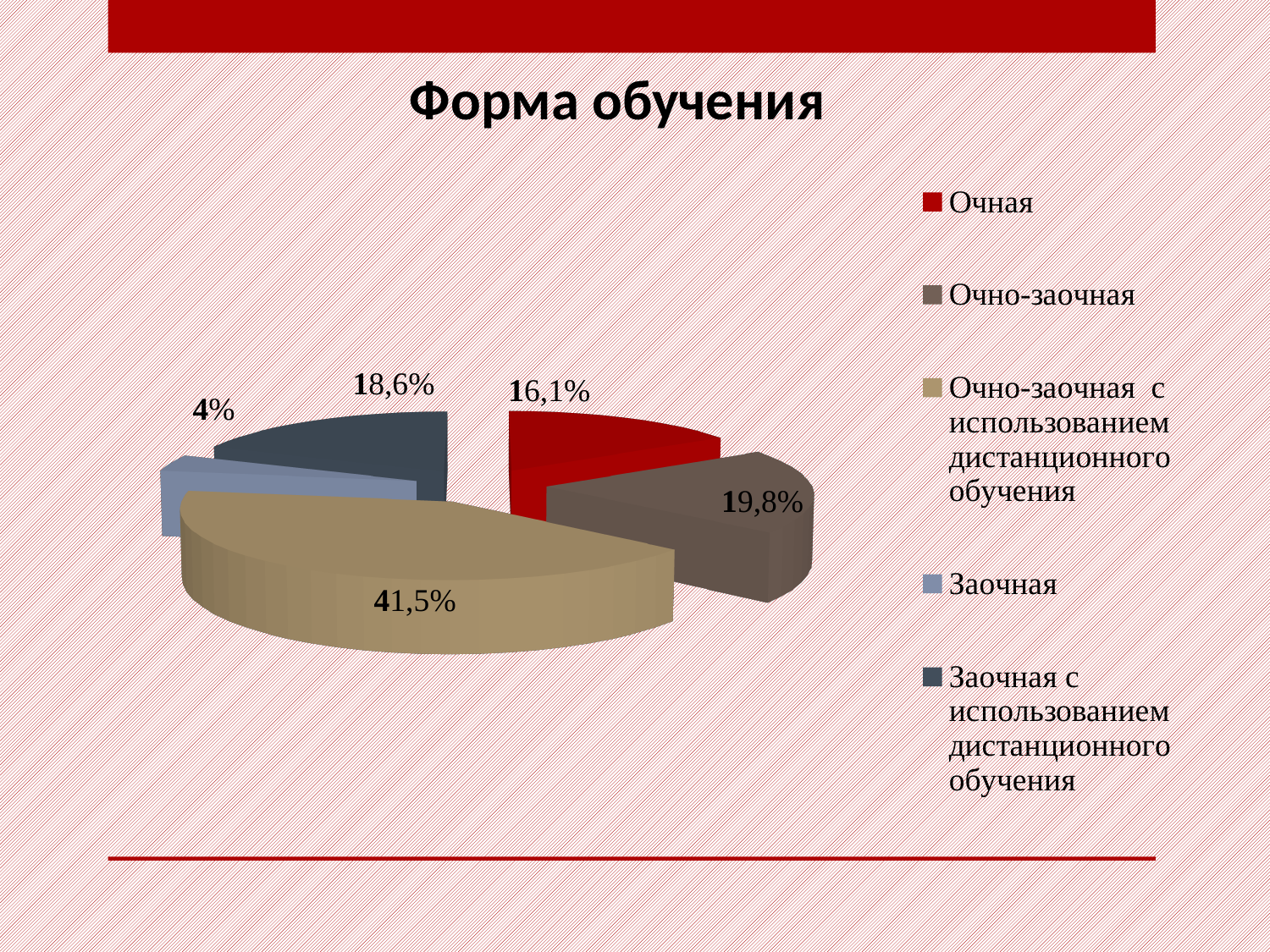
What percentage is shown for Заочная с использованием дистанционного обучения? 18,6% What is the difference between the share for Очно-заочная с использованием дистанционного обучения and the share for Очно-заочная? 21,7% What percentage is shown for Очно-заочная? 19,8% What kind of chart is shown on the slide? Pie chart What percentage is shown for Очная? 16,1% Which form of study has the largest share of the pie? Очно-заочная с использованием дистанционного обучения How many slices does the pie chart have? 5 Which form of study has the smallest share of the pie? Заочная What percentage is shown for Заочная? 4% What is the title of the chart? Форма обучения Which is larger, the share for Очно-заочная or the share for Очная? Очно-заочная What percentage is shown for Очно-заочная с использованием дистанционного обучения? 41,5%